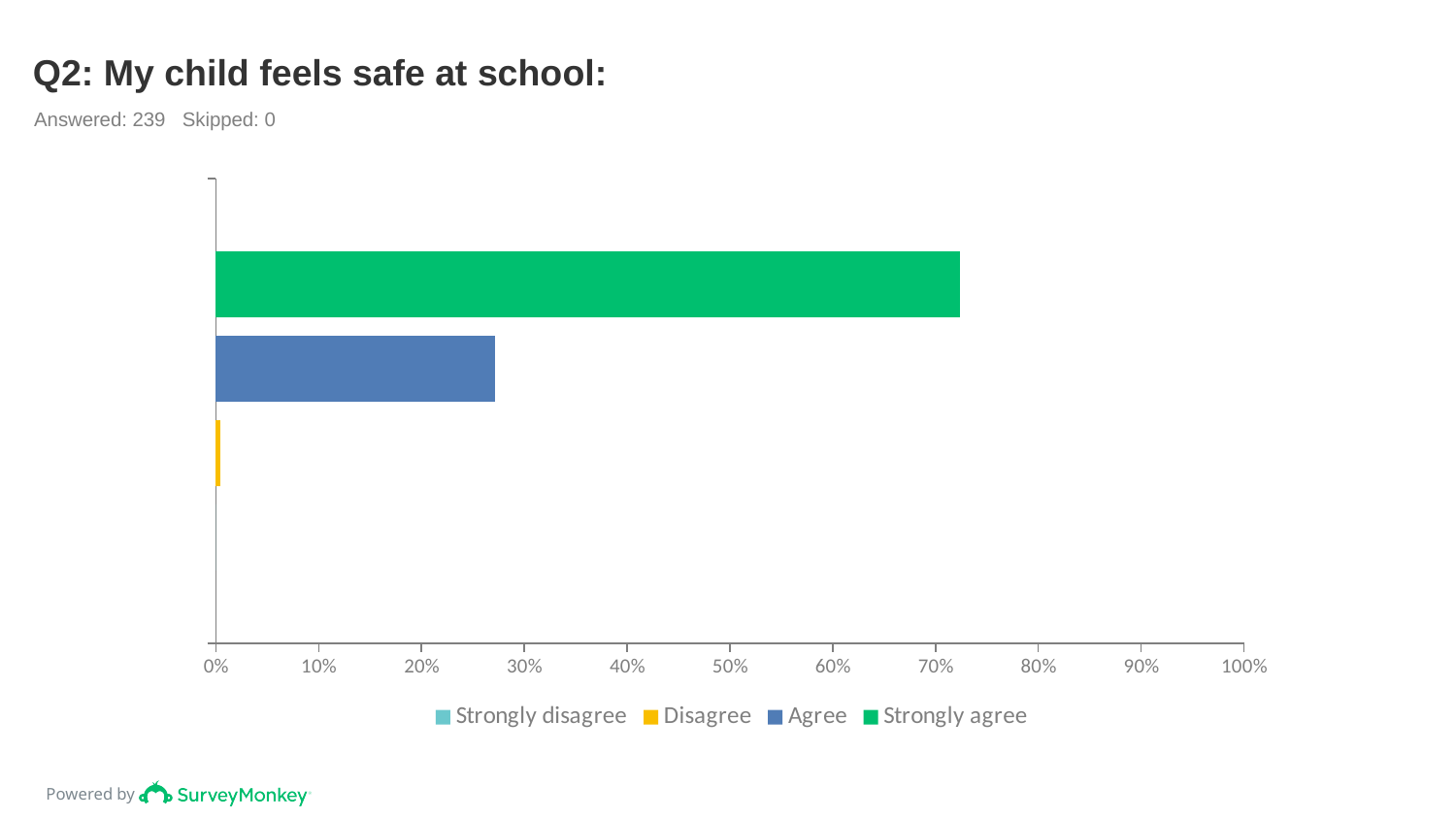
What kind of chart is shown on the slide? bar chart What is the title of the chart? Q2: My child feels safe at school: Which is larger, the value for Agree or the value for Disagree? Agree Which response option has the longest bar? Strongly agree Is the value for Agree greater or less than 30%? less How many respondents answered the question according to the slide? 239 Which is larger, the value for Strongly agree or the value for Agree? Strongly agree Is the value for Agree greater or less than 20%? greater Is the value for Strongly agree greater or less than 60%? greater How many series does the legend list? 4